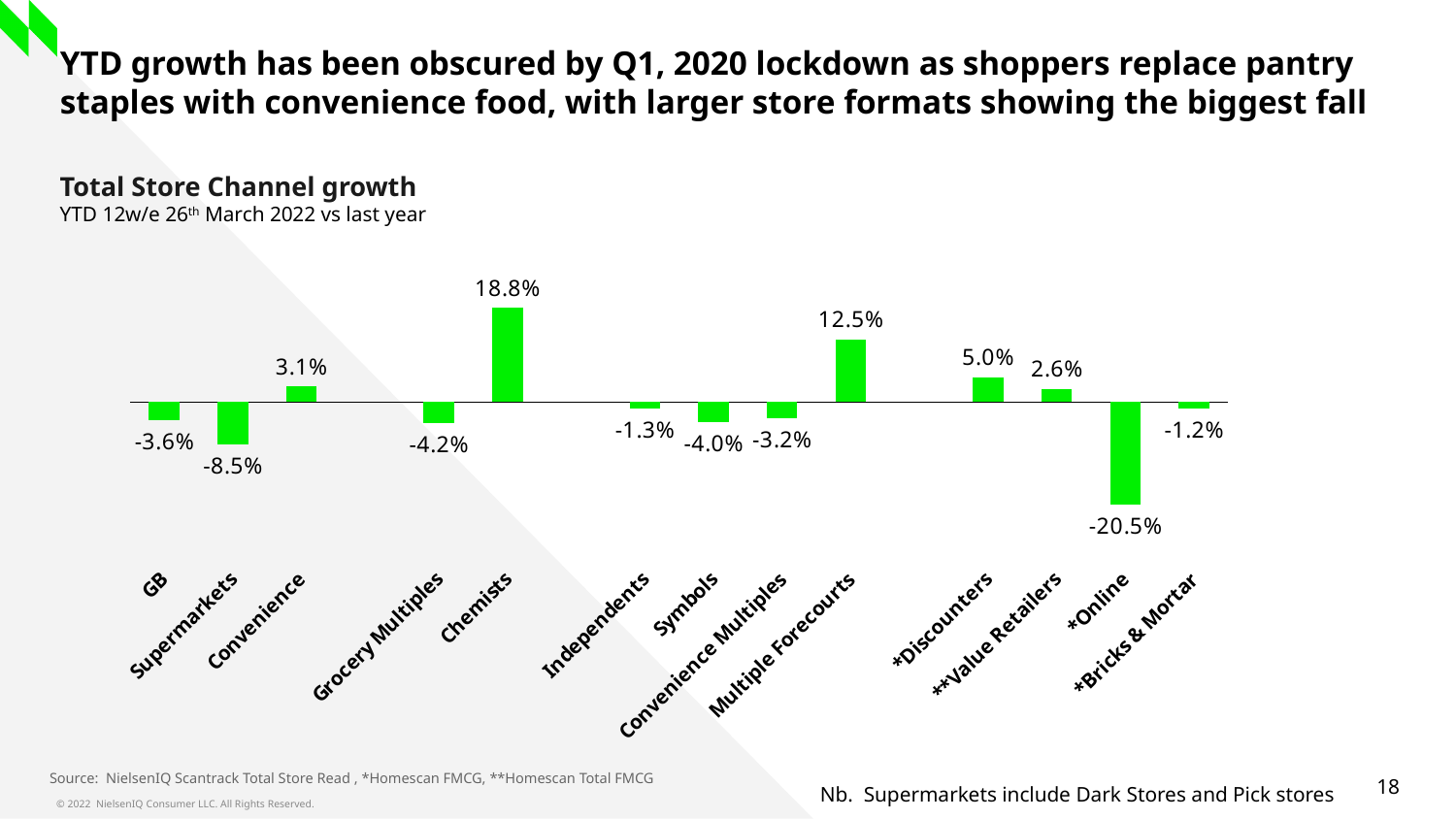
What is the growth value for Multiple Forecourts? 12.5% Which channel has the highest growth? Chemists What is the growth value for GB? -3.6% Which channel has the lowest growth? Online What is the growth value for Supermarkets? -8.5% Which has the larger growth value, Discounters or Value Retailers? Discounters What is the growth value for Chemists? 18.8% What is the growth value for Online? -20.5% What is the difference between the growth for Chemists and Multiple Forecourts? 6.3 percentage points How many channels are shown in the chart? 13 What type of chart is shown on the slide? Bar chart What is the title of the chart? Total Store Channel growth